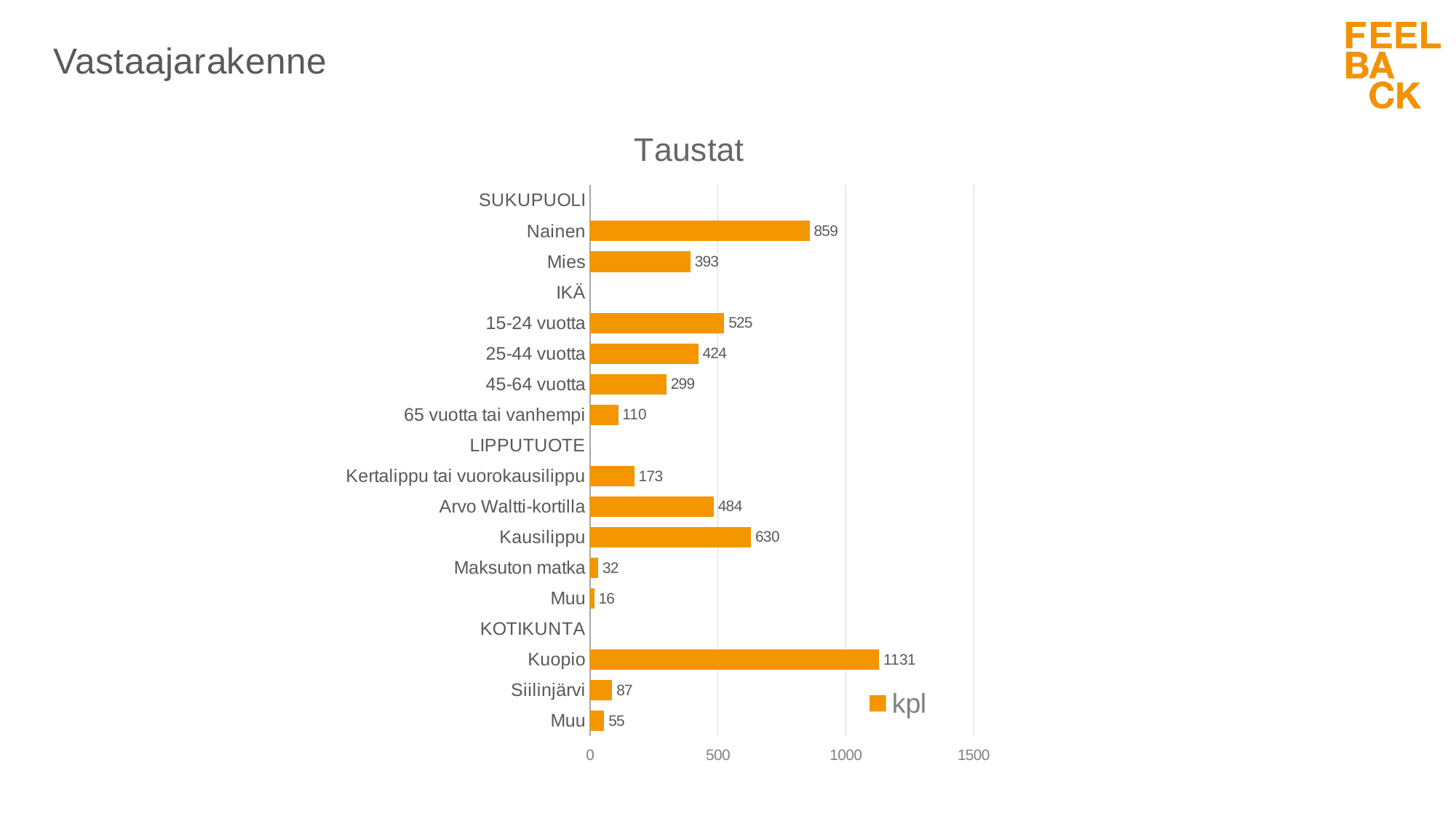
Which category has the highest value in the chart? Kuopio What is the difference between the values for Nainen and Mies? 466 How many series does the legend list? 1 What is the value for Siilinjärvi? 87 What kind of chart is shown on the slide? bar chart What is the value for 65 vuotta tai vanhempi? 110 Which category has the lowest value in the chart? Muu (under LIPPUTUOTE) Which is larger, the value for 15-24 vuotta or the value for 25-44 vuotta? 15-24 vuotta Is the value for Kuopio greater or less than 1000? greater What is the title of the chart? Taustat What is the value for Nainen? 859 What is the value for Kausilippu? 630